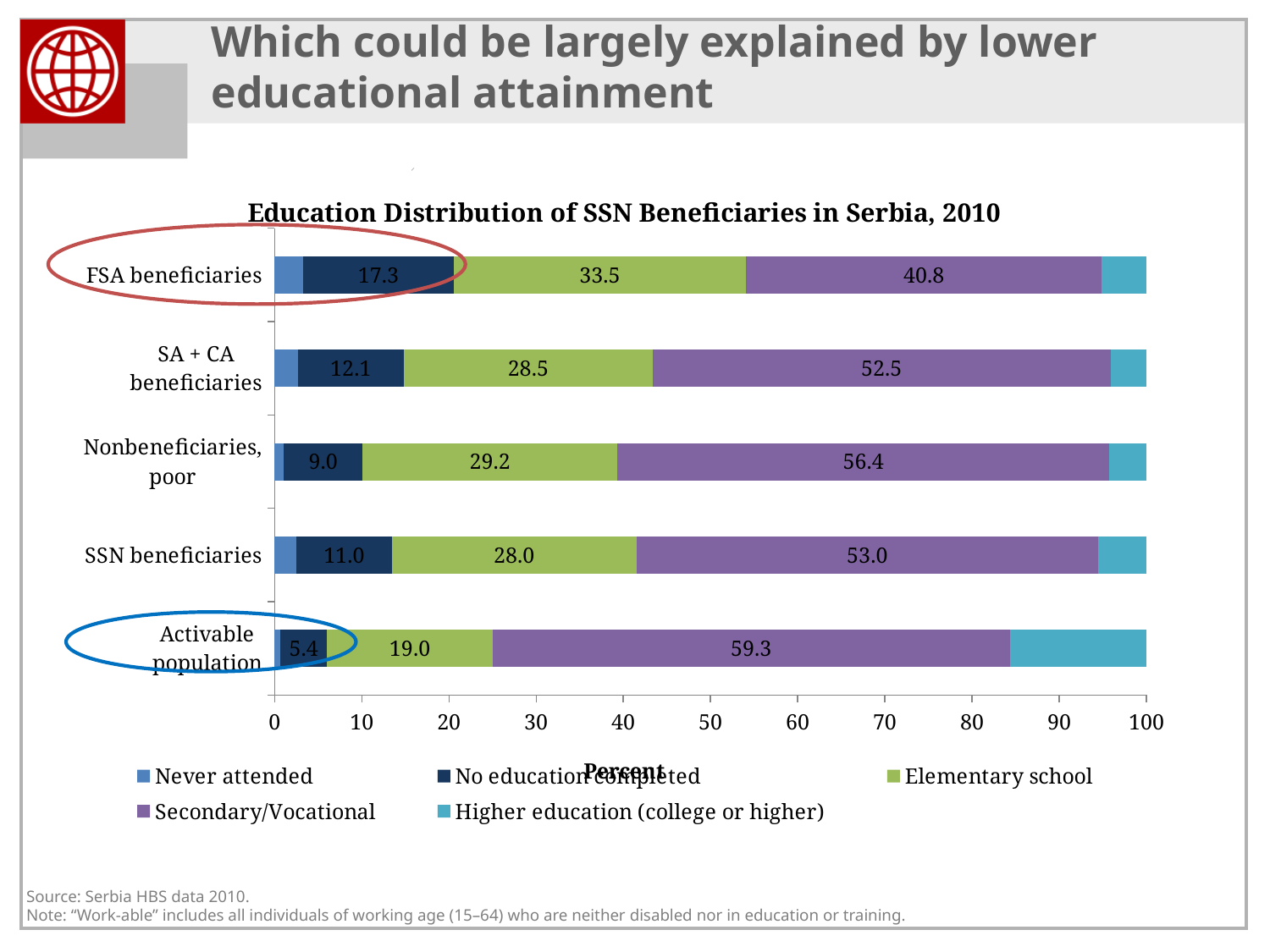
Which category has the highest No education completed value? FSA beneficiaries Which category has the lowest Elementary school value? Activable population What is the Secondary/Vocational value for the Activable population? 59.3 What is the value for No education completed for FSA beneficiaries? 17.3 Which category has the highest Secondary/Vocational value? Activable population Is the Higher education (college or higher) value for the Activable population greater or less than 10? greater How many categories are shown on the y axis? 5 What type of chart is shown? Stacked bar chart What is the difference between the No education completed values for FSA beneficiaries and the Activable population? 11.9 What is the Elementary school value for Nonbeneficiaries, poor? 29.2 How many series does the legend list? 5 Which has a larger Elementary school value, FSA beneficiaries or SA + CA beneficiaries? FSA beneficiaries